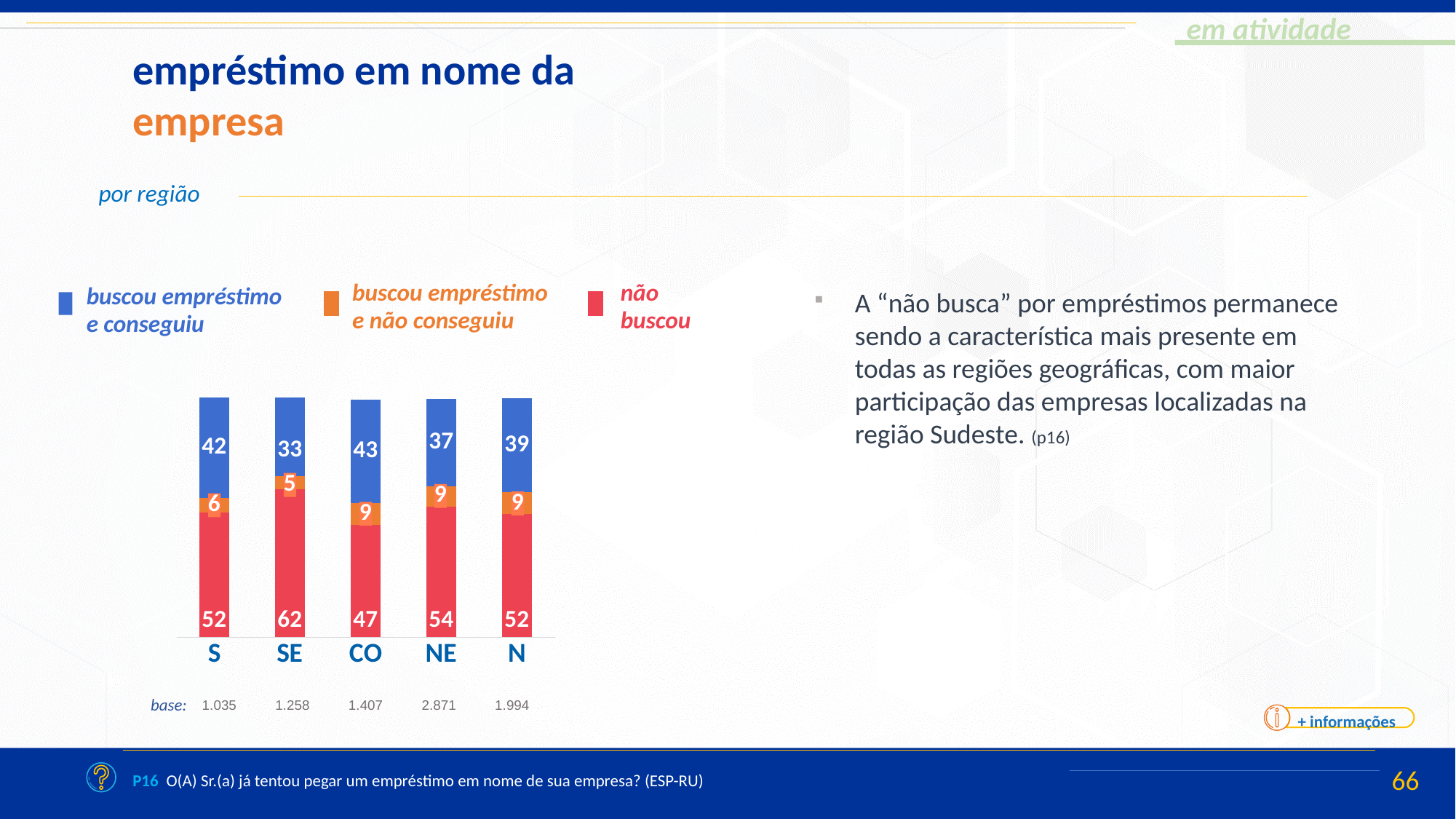
How many series does the legend list? 3 What is the value of 'buscou empréstimo e conseguiu' for region CO? 43 What is the difference between the 'não buscou' values for SE and CO? 15 What kind of chart is shown on the slide? stacked bar chart What is the base (sample size) shown for region NE? 2.871 What is the value of 'buscou empréstimo e não conseguiu' for region S? 6 What is the total of the stacked bar for region CO? 99 How many regions are shown on the x axis of the chart? 5 Which region has the lowest value for 'buscou empréstimo e conseguiu'? SE Which is larger: the 'buscou empréstimo e conseguiu' value for NE or for N? N What is the value of 'não buscou' for region SE? 62 Which region has the highest value for 'não buscou'? SE